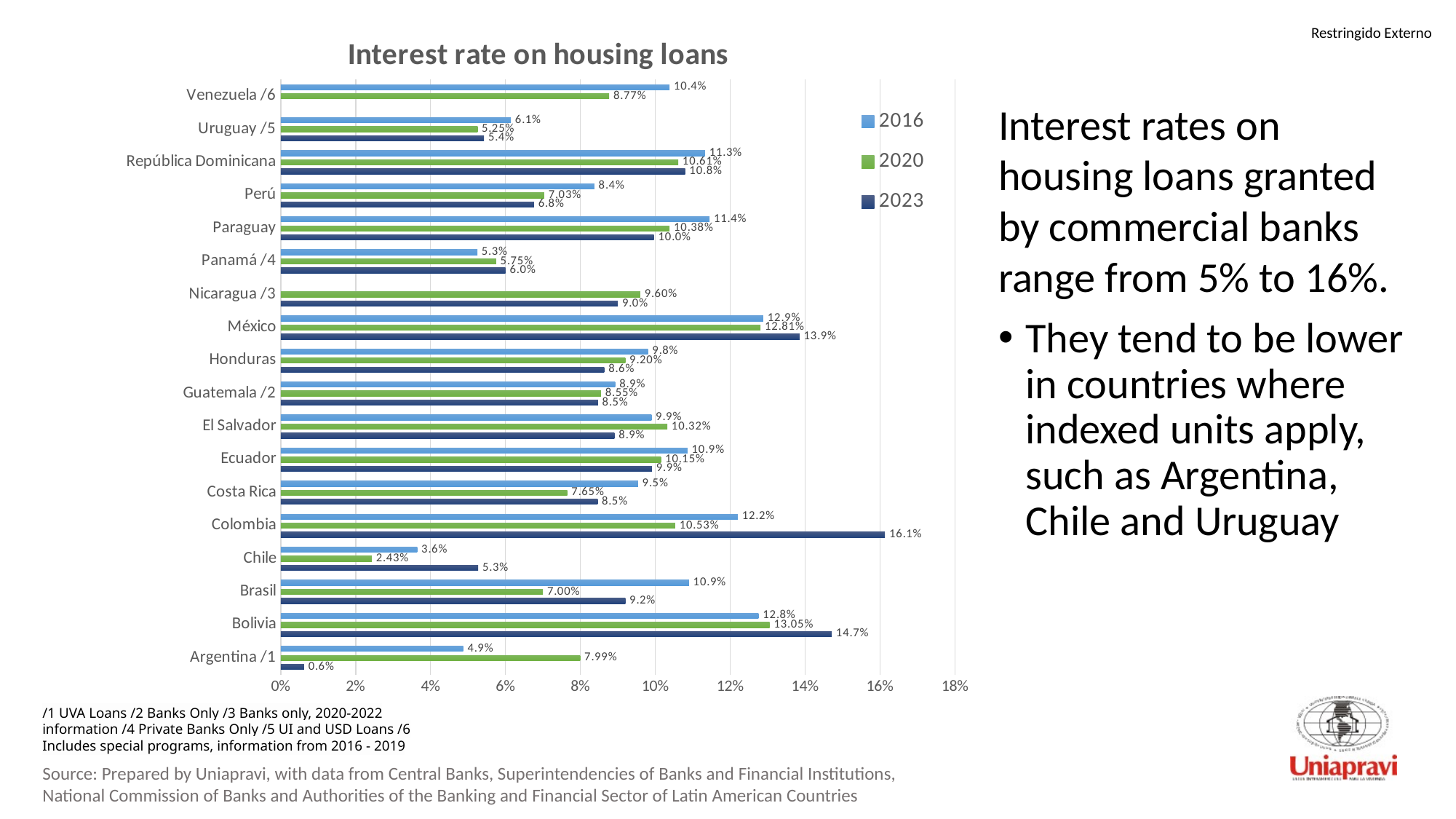
How many countries are listed on the chart? 18 Is the 2023 interest rate for Bolivia greater or less than 14%? greater What is the 2016 interest rate on housing loans for Venezuela /6? 10.4% How many series does the legend list? 3 Which country has the lowest 2020 interest rate on housing loans? Chile Which country has the highest 2023 interest rate on housing loans? Colombia What is the 2023 interest rate on housing loans for Colombia? 16.1% Which is larger: Bolivia's 2023 rate or México's 2023 rate? Bolivia's 2023 rate What is the 2020 interest rate on housing loans for Argentina /1? 7.99% Which country has the lowest 2023 interest rate on housing loans? Argentina /1 What kind of chart is shown on the slide? Bar chart By how many percentage points did Colombia's interest rate rise from 2016 to 2023? 3.9 percentage points